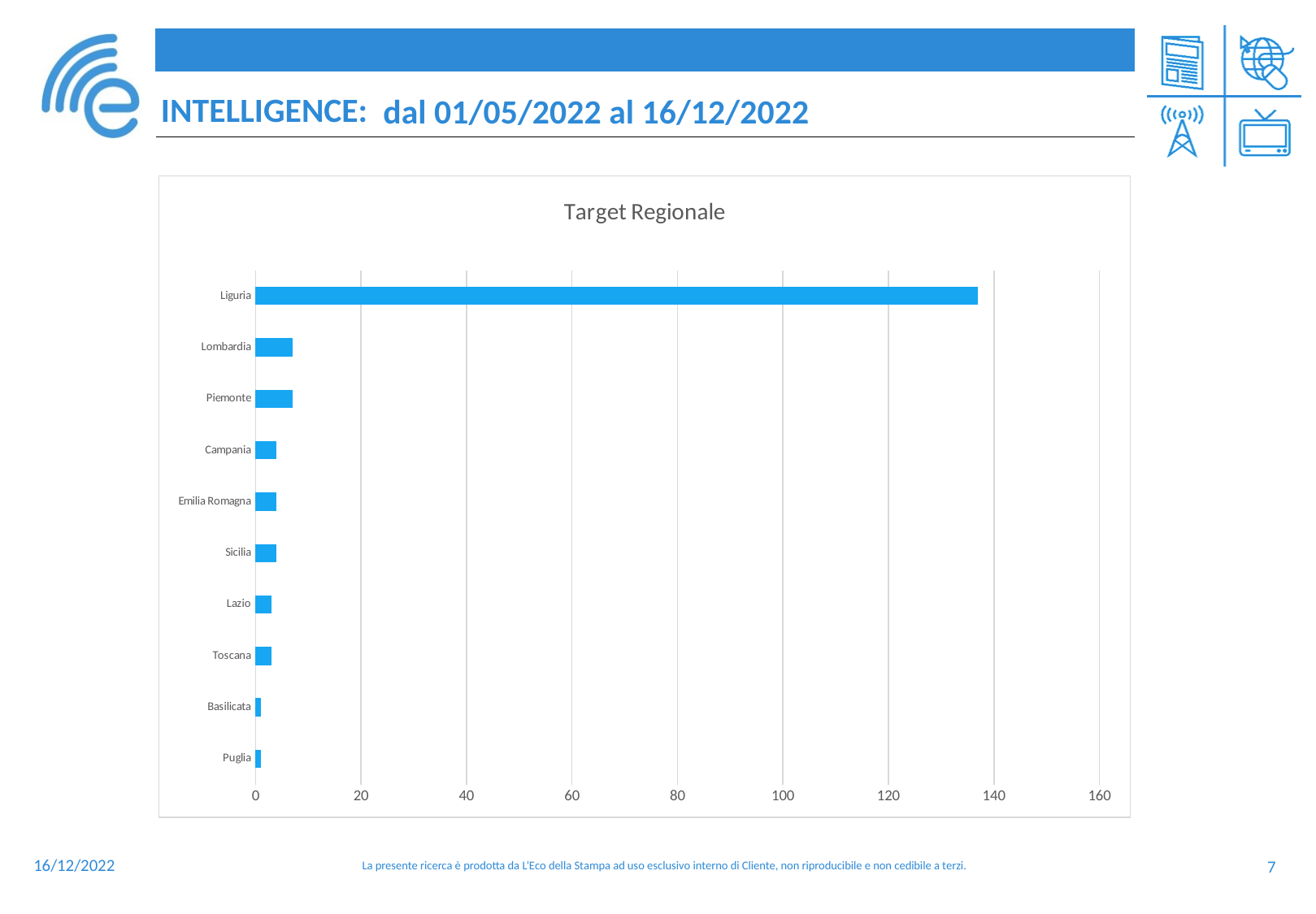
Is the value for Lombardia greater or less than 20? less Which has a larger value, Liguria or Lombardia? Liguria Which region has the highest value in the chart? Liguria How many regions are shown in the chart? 10 Is the value for Toscana greater or less than 20? less Is the value for Liguria greater or less than 120? greater What kind of chart is shown on the slide? bar chart What is the title of the chart? Target Regionale Which has a larger value, Piemonte or Puglia? Piemonte Which region is listed at the bottom of the chart? Puglia